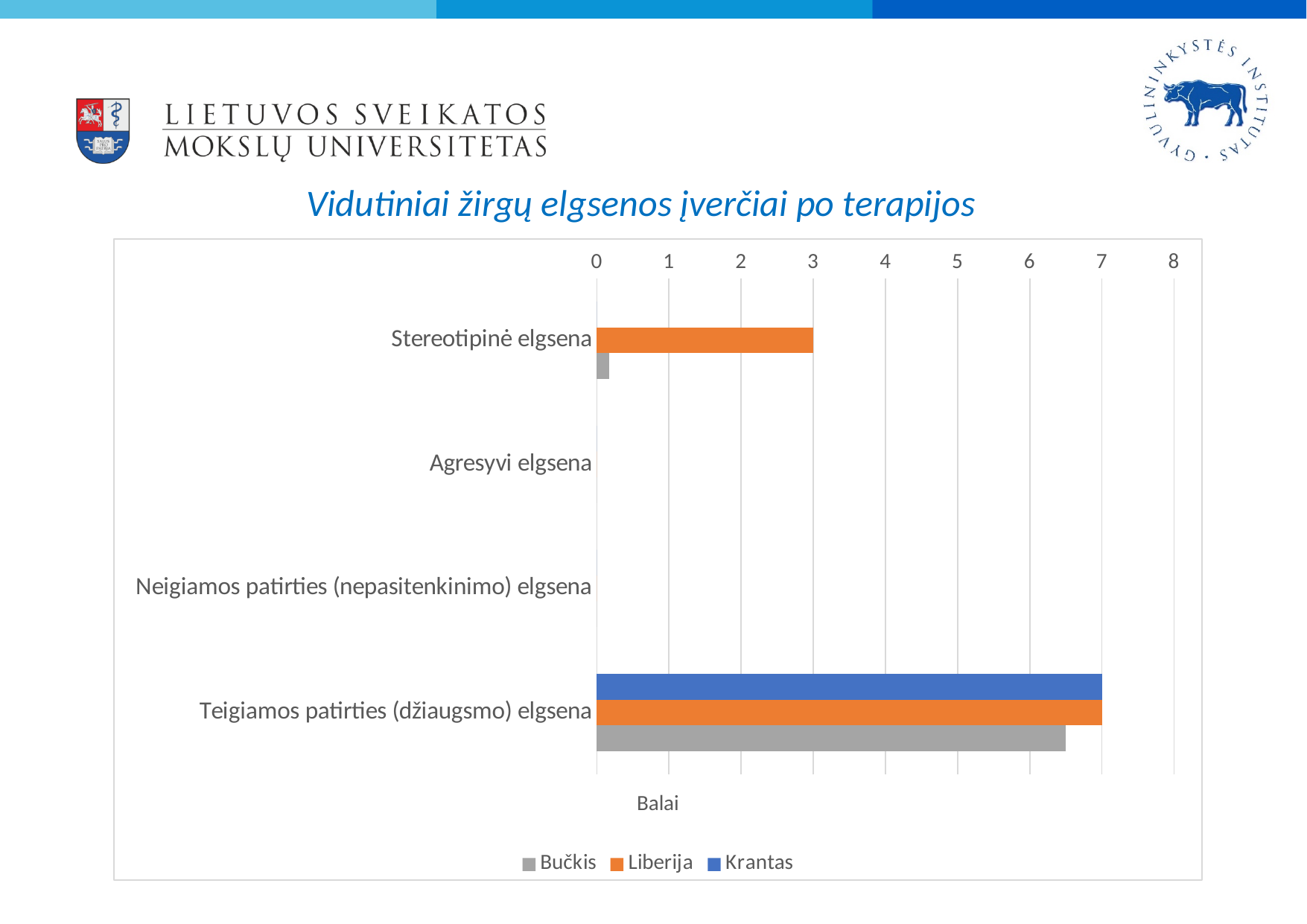
How many series does the legend list? 3 Is the value for Bučkis in Teigiamos patirties (džiaugsmo) elgsena greater or less than 6? greater What is the value for Liberija in the category Stereotipinė elgsena? 3 What is the value for Liberija in the category Teigiamos patirties (džiaugsmo) elgsena? 7 Is the value for Bučkis in Stereotipinė elgsena greater or less than 1? less What is the label of the horizontal axis? Balai What is the value for Krantas in the category Teigiamos patirties (džiaugsmo) elgsena? 7 How many behaviour categories are shown on the vertical axis? 4 What type of chart is shown on the slide? bar chart In the category Stereotipinė elgsena, which is larger: the value for Liberija or the value for Bučkis? Liberija What is the title of the chart? Vidutiniai žirgų elgsenos įverčiai po terapijos What is the difference between Liberija's value in Teigiamos patirties (džiaugsmo) elgsena and its value in Stereotipinė elgsena? 4